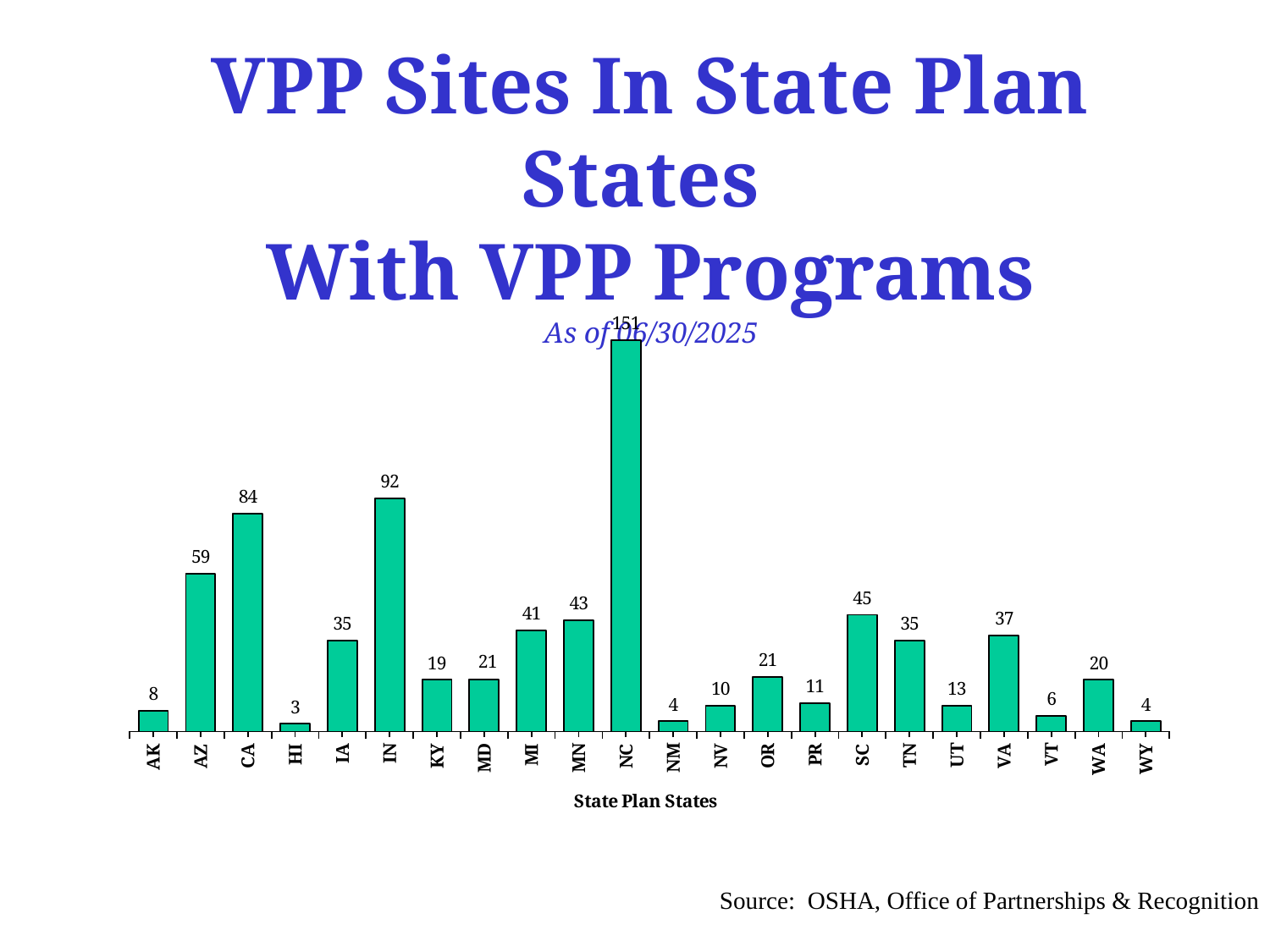
What is the value shown for SC? 45 Which has a larger value, MI or MN? MN What is the difference between the values for VA and UT? 24 Which state has the lowest number of VPP sites? HI What is the x-axis title of the chart? State Plan States How many states are shown on the x axis? 22 What is the difference between the values for CA and AZ? 25 Which state has the highest number of VPP sites? NC What type of chart is shown on the slide? bar chart How many VPP sites does CA have? 84 What is the value shown for IN? 92 What is the value shown for VT? 6